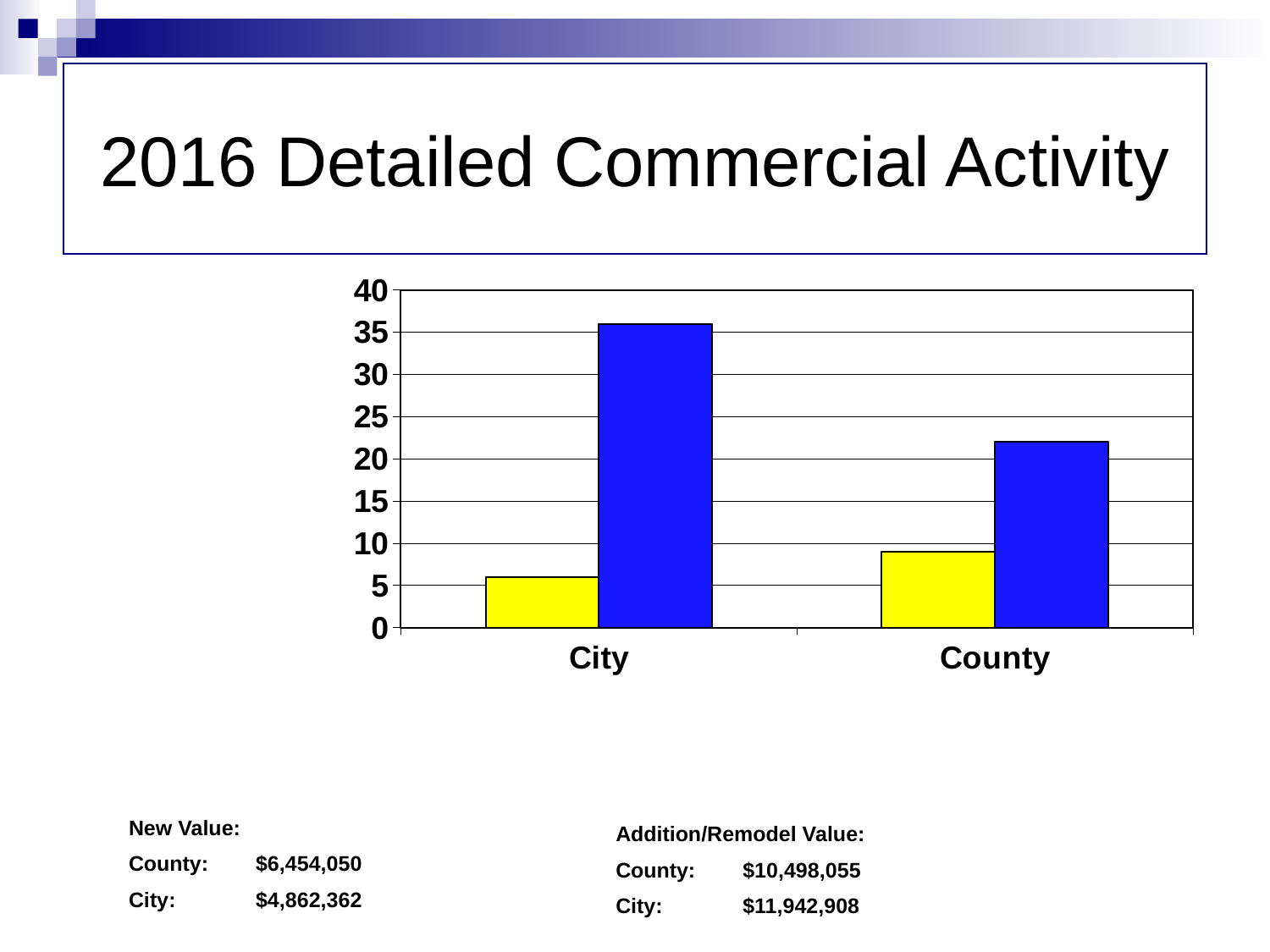
Which category has the tallest bar in the chart? City What two colours are used for the bars in the chart? yellow and blue Which is larger: the blue bar for City or the blue bar for County? City Is the value of the blue bar for City greater or less than 30? greater What kind of chart is shown on the slide? bar chart Is the value of the yellow bar for City greater or less than 10? less Is the value of the blue bar for County greater or less than 20? greater How many categories are shown on the x axis of the chart? 2 What is the highest value shown on the y axis of the chart? 40 Which is larger: the yellow bar for City or the yellow bar for County? County